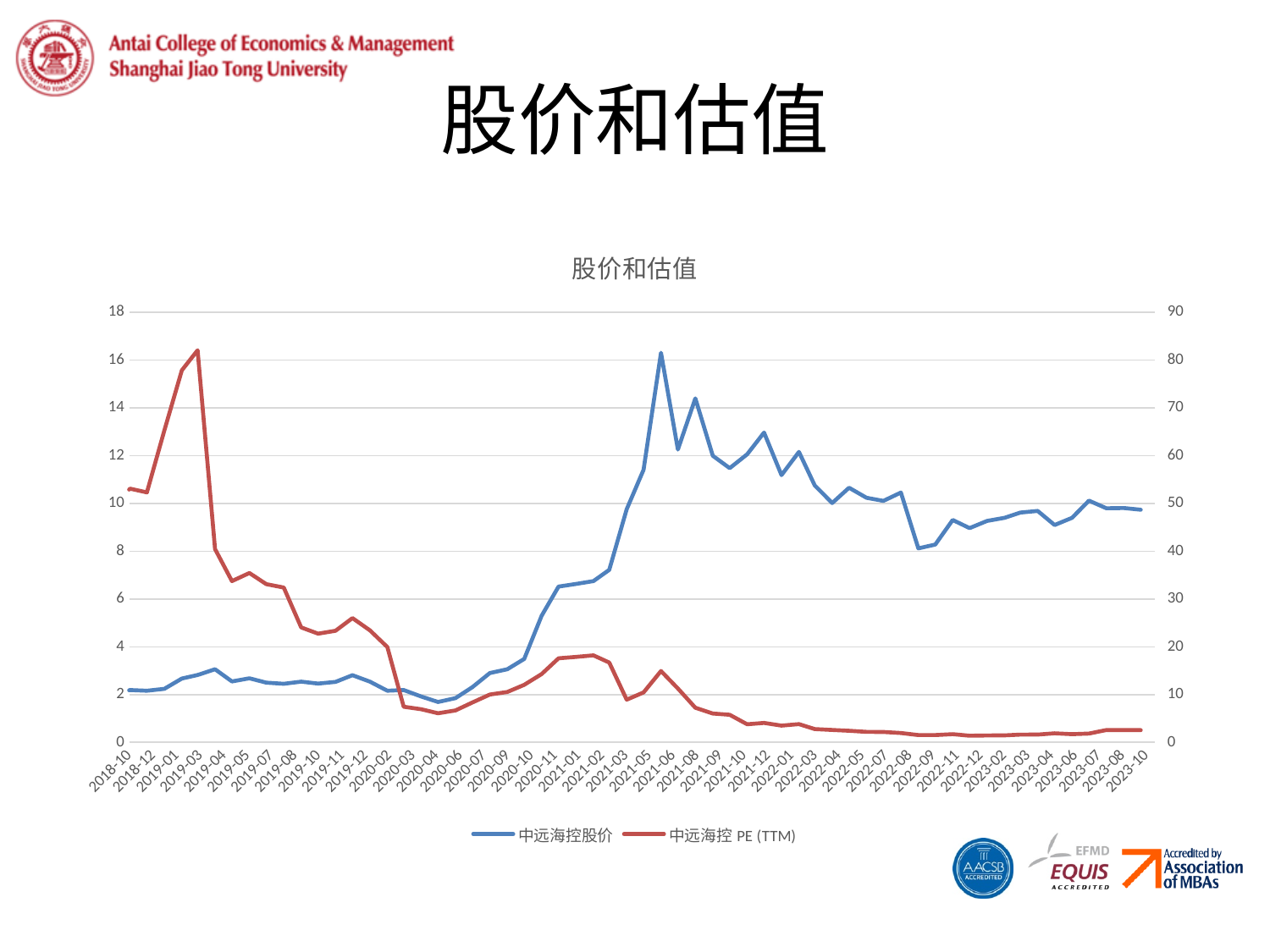
In which month does the 中远海控股价 line reach its highest point? 2021-06 How many series does the legend list? 2 Does the 中远海控股价 line rise or fall between 2020-04 and 2021-06? rise In which month does the 中远海控 PE (TTM) line reach its highest point? 2019-03 Which series is drawn in red? 中远海控 PE (TTM) Is the value for 中远海控 PE (TTM) in 2019-03 greater or less than 70 on the right axis? greater Is the value for 中远海控股价 in 2018-10 greater or less than 4 on the left axis? less Is the value for 中远海控股价 in 2021-06 greater or less than 14 on the left axis? greater What is the title of the chart? 股价和估值 What kind of chart is shown on the slide? line chart Does the 中远海控 PE (TTM) line rise or fall between 2019-03 and 2020-04? fall